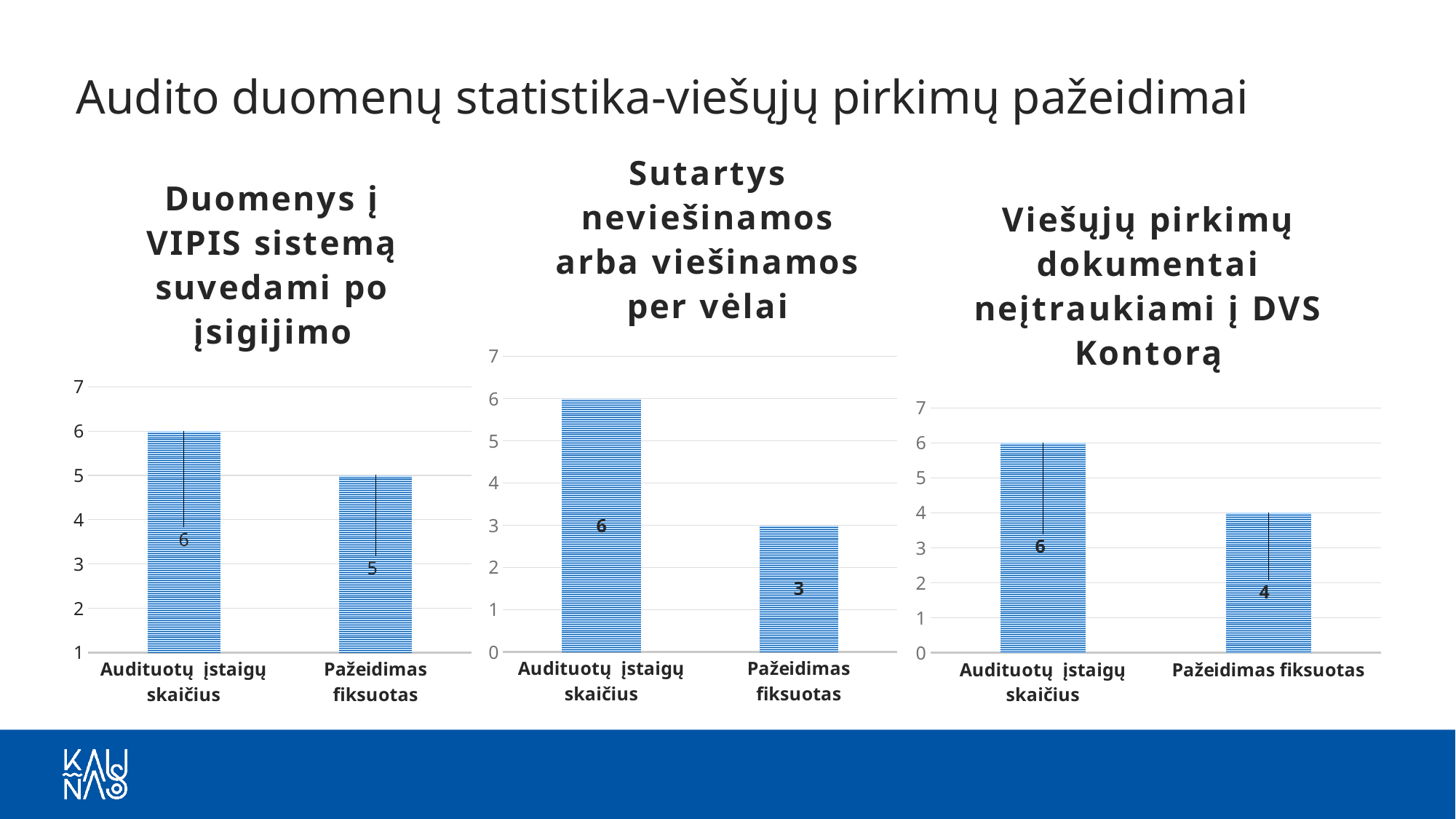
How many categories does the right chart (Viešųjų pirkimų dokumentai neįtraukiami į DVS Kontorą) show? 2 In the left chart (Duomenys į VIPIS sistemą suvedami po įsigijimo), what is the value for Audituotų įstaigų skaičius? 6 In the middle chart (Sutartys neviešinamos arba viešinamos per vėlai), what is the difference between Audituotų įstaigų skaičius and Pažeidimas fiksuotas? 3 In the middle chart (Sutartys neviešinamos arba viešinamos per vėlai), what is the value for Pažeidimas fiksuotas? 3 In the left chart (Duomenys į VIPIS sistemą suvedami po įsigijimo), which category has the lower value? Pažeidimas fiksuotas In the right chart (Viešųjų pirkimų dokumentai neįtraukiami į DVS Kontorą), what is the value for Pažeidimas fiksuotas? 4 In the right chart (Viešųjų pirkimų dokumentai neįtraukiami į DVS Kontorą), is the value for Audituotų įstaigų skaičius larger or smaller than the value for Pažeidimas fiksuotas? larger In the left chart (Duomenys į VIPIS sistemą suvedami po įsigijimo), what is the value for Pažeidimas fiksuotas? 5 In the middle chart (Sutartys neviešinamos arba viešinamos per vėlai), which category has the higher value? Audituotų įstaigų skaičius How many charts are shown on the slide? 3 In the right chart (Viešųjų pirkimų dokumentai neįtraukiami į DVS Kontorą), what is the difference between Audituotų įstaigų skaičius and Pažeidimas fiksuotas? 2 What kind of chart is the middle chart (Sutartys neviešinamos arba viešinamos per vėlai)? bar chart